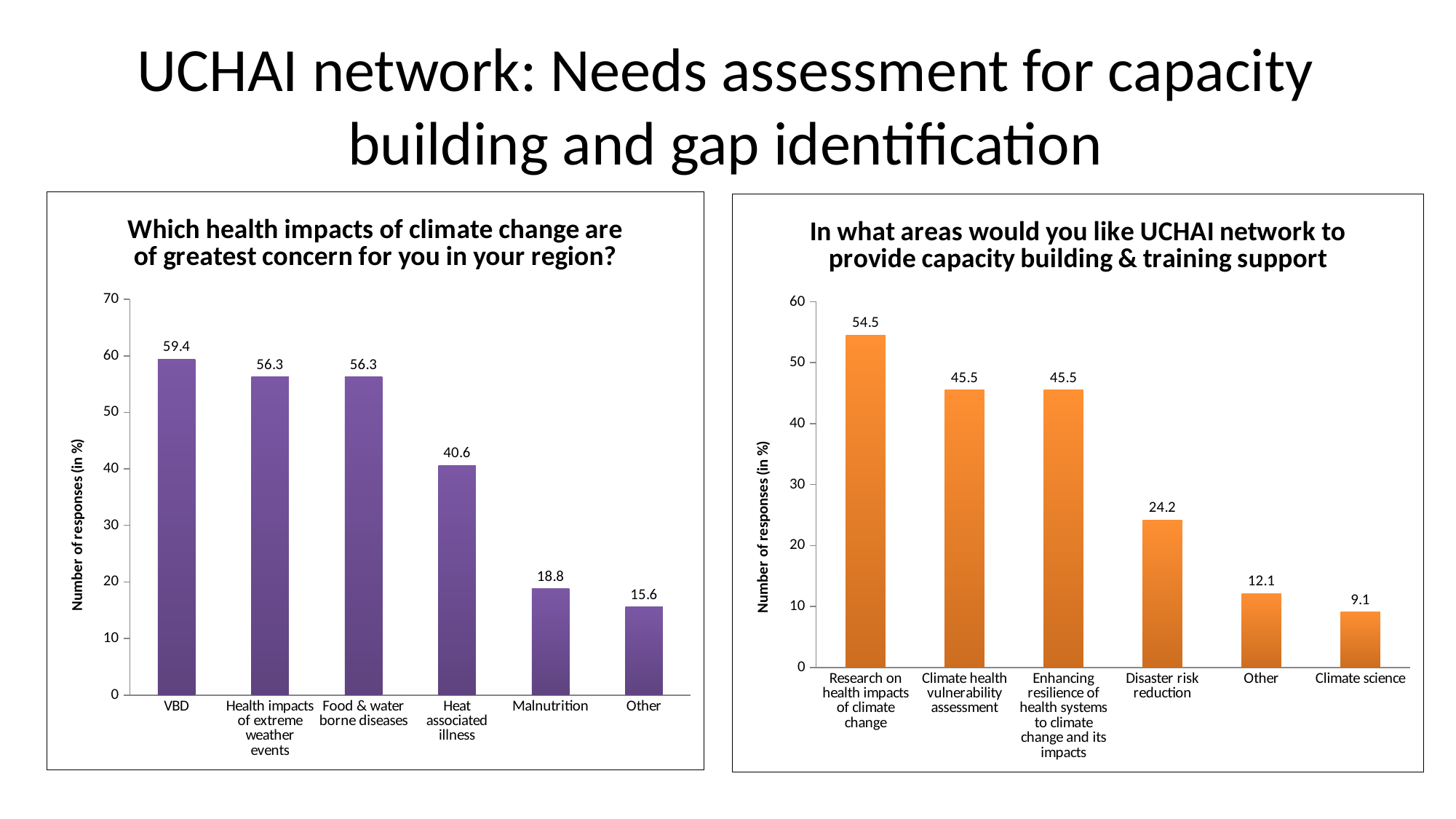
In the right chart (areas for capacity building & training support), which category has the highest value? Research on health impacts of climate change In the left chart (health impacts of climate change of greatest concern), what is the difference between the values for Heat associated illness and Malnutrition? 21.8 In the left chart (health impacts of climate change of greatest concern), what is the value for Malnutrition? 18.8 In the right chart (areas for capacity building & training support), which is larger: the value for Other or the value for Climate science? Other In the right chart (areas for capacity building & training support), what is the difference between the values for Research on health impacts of climate change and Climate health vulnerability assessment? 9.0 In the right chart (areas for capacity building & training support), what is the label of the y axis? Number of responses (in %) In the left chart (health impacts of climate change of greatest concern), what is the value for VBD? 59.4 In the right chart (areas for capacity building & training support), do the values rise or fall from left to right along the x axis? Fall In the right chart (areas for capacity building & training support), what is the value for Disaster risk reduction? 24.2 In the left chart (health impacts of climate change of greatest concern), what kind of chart is it? Bar chart In the left chart (health impacts of climate change of greatest concern), which category has the lowest value? Other In the left chart (health impacts of climate change of greatest concern), how many categories are shown on the x axis? 6